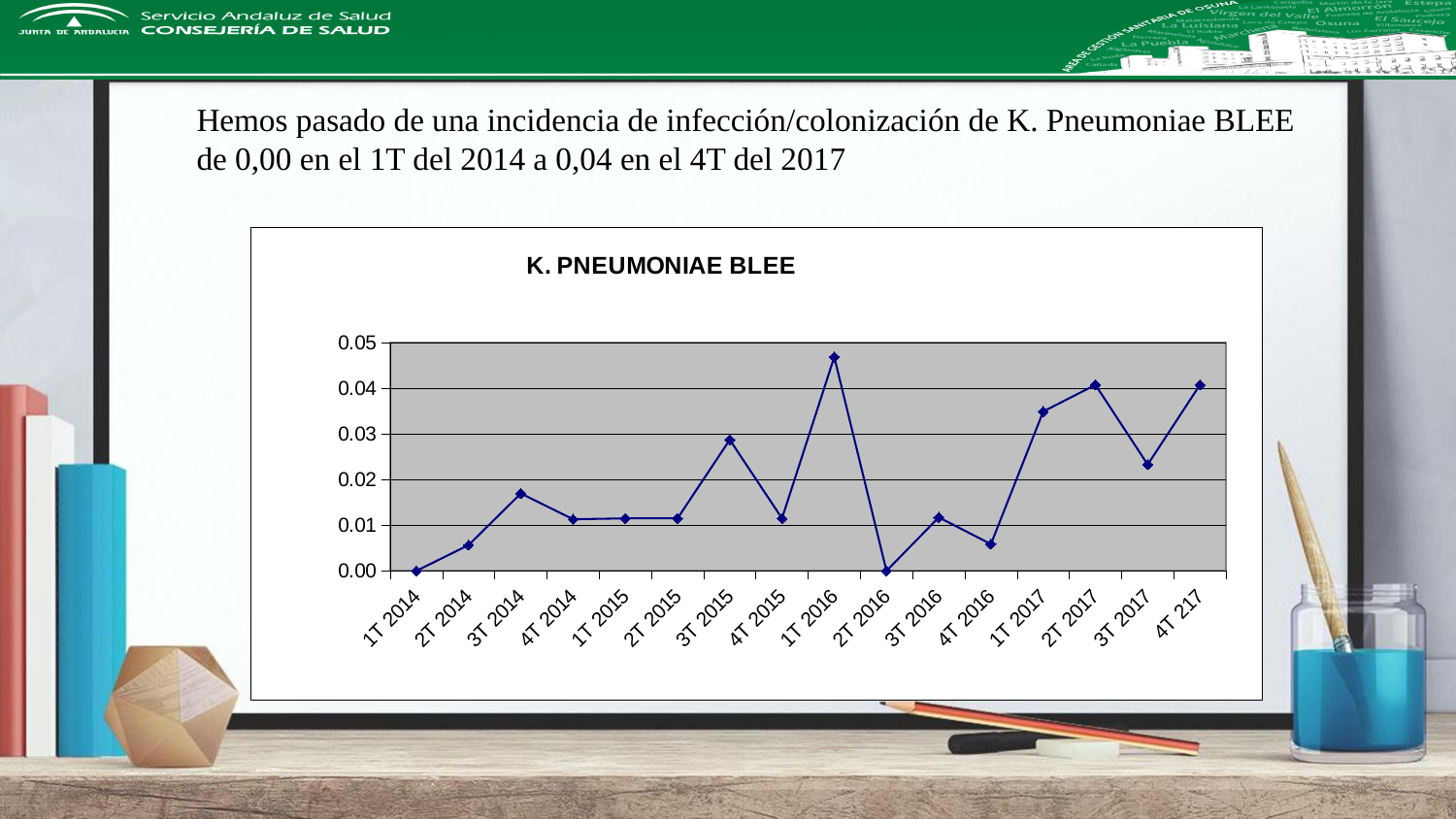
Is the value for 4T 2016 greater or less than 0.01? less What kind of chart is shown on the slide? line chart What is the title of the chart? K. PNEUMONIAE BLEE Which is larger, the value for 1T 2016 or the value for 2T 2016? 1T 2016 Is the value for 3T 2015 greater or less than 0.02? greater What is the value for 1T 2014 in the chart? 0.00 What is the value for 2T 2016 in the chart? 0.00 Which quarter has the highest value in the chart? 1T 2016 How many quarters (data points) are plotted on the x axis of the chart? 16 Is the value for 3T 2017 greater or less than 0.03? less Do the values rise or fall from 2T 2016 to 2T 2017? rise